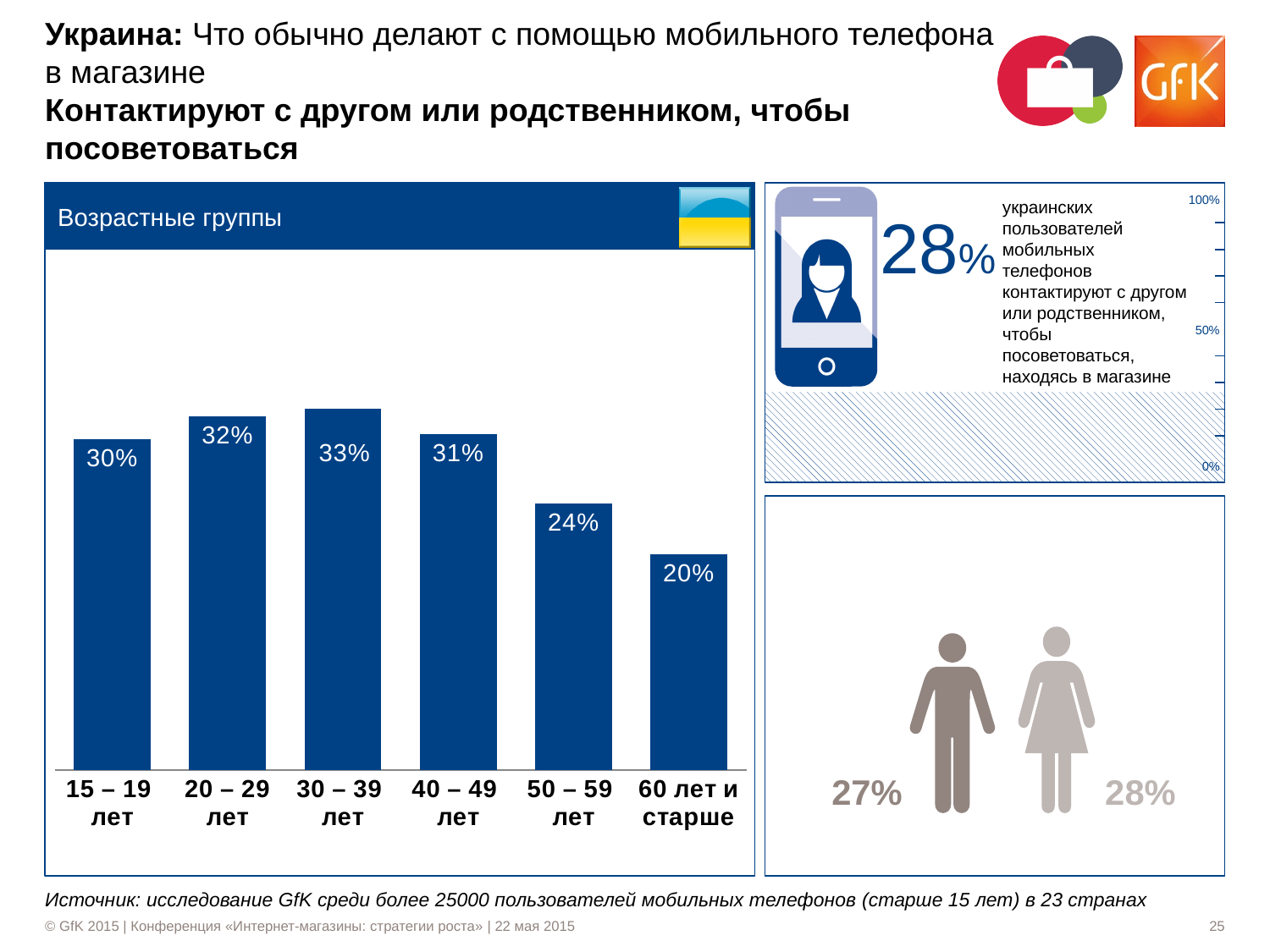
In the 'Возрастные группы' bar chart, do the values rise or fall from '40 – 49 лет' to '60 лет и старше'? fall In the 'Возрастные группы' bar chart, which age group has the lowest value? 60 лет и старше In the 'Возрастные группы' bar chart, which age group has the highest value? 30 – 39 лет In the 'Возрастные группы' bar chart, what is the value for the '50 – 59 лет' age group? 24% What kind of chart is the 'Возрастные группы' chart? bar chart How many age groups are shown in the 'Возрастные группы' bar chart? 6 In the 'Возрастные группы' bar chart, which is larger: the value for '20 – 29 лет' or for '50 – 59 лет'? 20 – 29 лет In the 'Возрастные группы' bar chart, what is the difference between the values for '30 – 39 лет' and '60 лет и старше'? 13% In the 'Возрастные группы' bar chart, what is the value for the '60 лет и старше' age group? 20% In the 'Возрастные группы' bar chart, what is the value for the '30 – 39 лет' age group? 33% In the top-right infographic, what share of Ukrainian mobile phone users contact a friend or relative for advice while in a store? 28% In the bottom-right gender infographic, what is the value shown for men? 27%